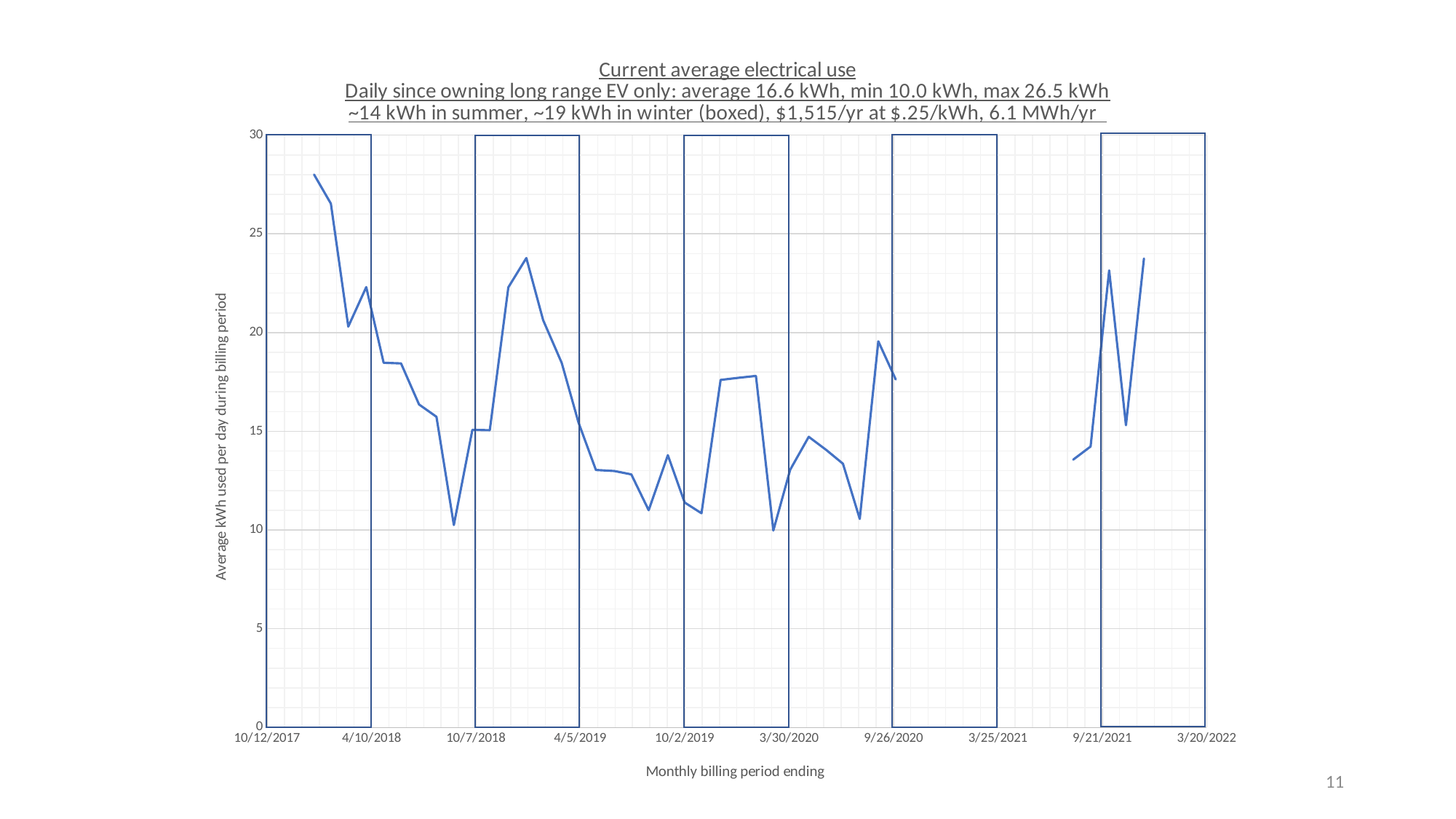
What is the label of the vertical axis? Average kWh used per day during billing period Is the first plotted value (just after 10/12/2017) greater or less than 25? greater Which is larger, the value at 10/2/2019 or the value at 9/26/2020? 9/26/2020 What is the label of the horizontal axis? Monthly billing period ending How many data series are plotted on the chart? 1 What kind of chart is shown on the slide? line chart Is the value plotted at 9/26/2020 greater or less than 15? greater Is the lowest point of the line greater or less than 15? less Do the values rise or fall between 10/12/2017 and 4/10/2018? fall